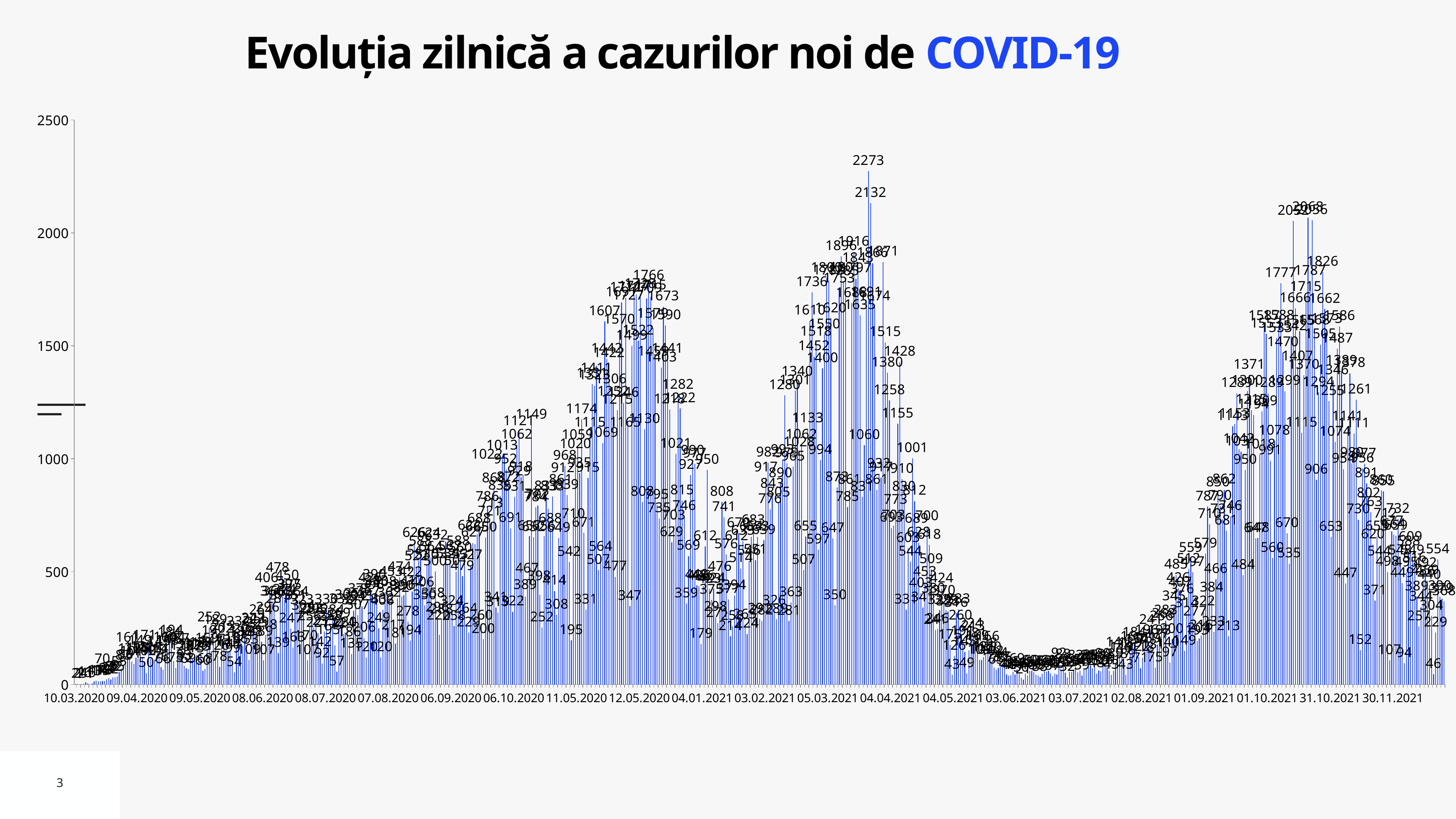
What is the value labelled on the last bar at the far right of the chart? 368 Do the values rise or fall between 04.04.2021 and 03.06.2021? fall Are the values between 03.06.2021 and 03.07.2021 greater or less than 500? less Is the peak value around 04.04.2021 greater or less than 2000? greater What is the highest daily value labelled on the chart? 2273 Do the values rise or fall between 02.08.2021 and 01.10.2021? rise What is the difference between the two highest labelled values, 2273 and 2132? 141 What is the title of the chart? Evoluția zilnică a cazurilor noi de COVID-19 Which is larger, the peak value around 04.04.2021 or the peak value around 31.10.2021? the peak around 04.04.2021 What is the second-highest value labelled near the peak around 04.04.2021? 2132 What kind of chart is shown on the slide? bar chart What is the highest value shown on the vertical axis? 2500